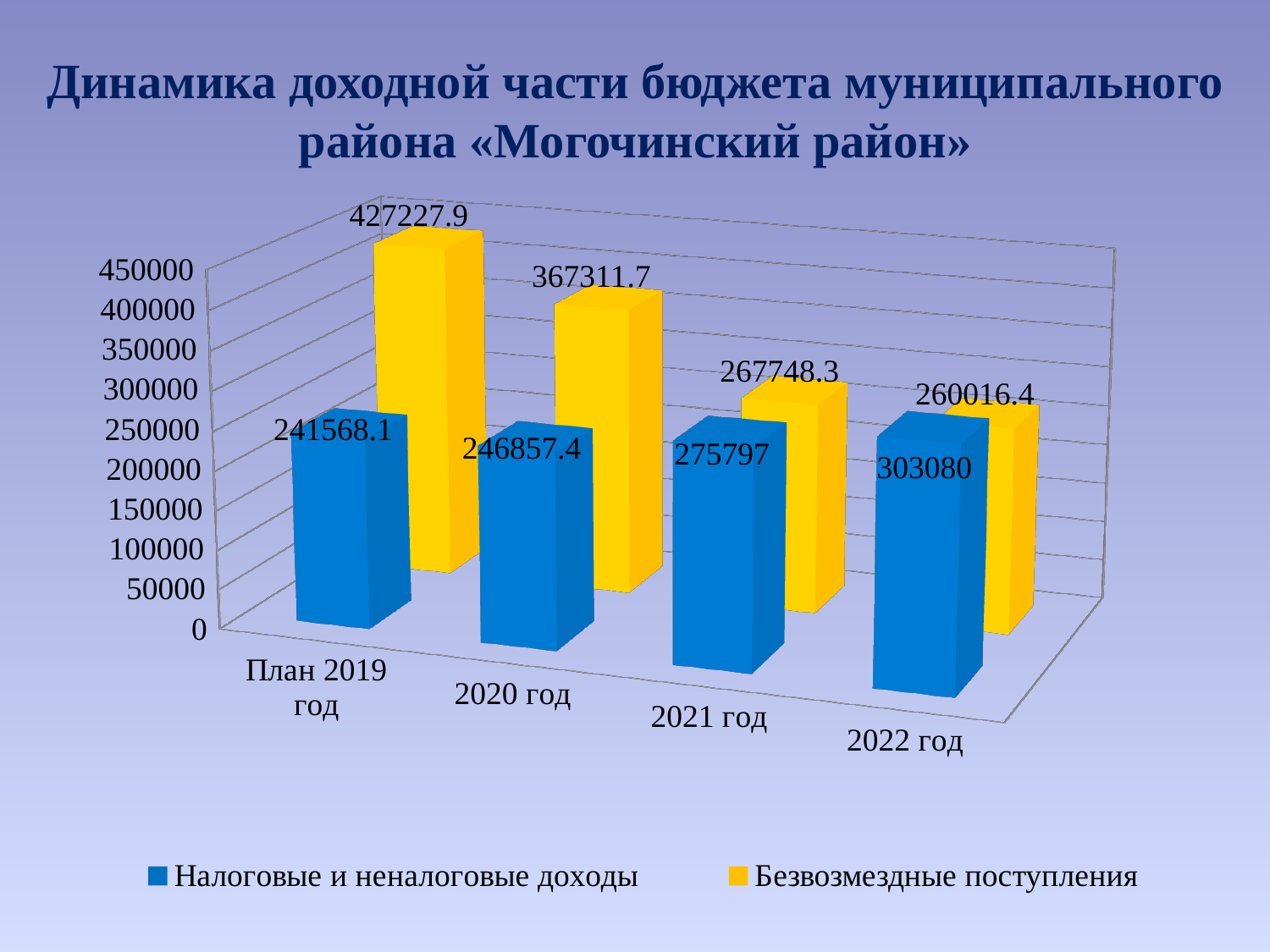
What is the value of Безвозмездные поступления for План 2019 год? 427227.9 In which category is Налоговые и неналоговые доходы the lowest? План 2019 год How many series does the legend list? 2 What kind of chart is shown on the slide? Bar chart Do the values of Налоговые и неналоговые доходы rise or fall from План 2019 год to 2022 год? Rise What is the value of Налоговые и неналоговые доходы for 2022 год? 303080 What is the total of Налоговые и неналоговые доходы and Безвозмездные поступления for 2020 год? 614169.1 By how much did Безвозмездные поступления decrease from План 2019 год to 2020 год? 59916.2 In which category is Безвозмездные поступления the highest? План 2019 год What is the difference between Налоговые и неналоговые доходы and Безвозмездные поступления in 2022 год? 43063.6 In 2021 год, which series has the larger value: Налоговые и неналоговые доходы or Безвозмездные поступления? Налоговые и неналоговые доходы How many categories are shown on the x axis? 4